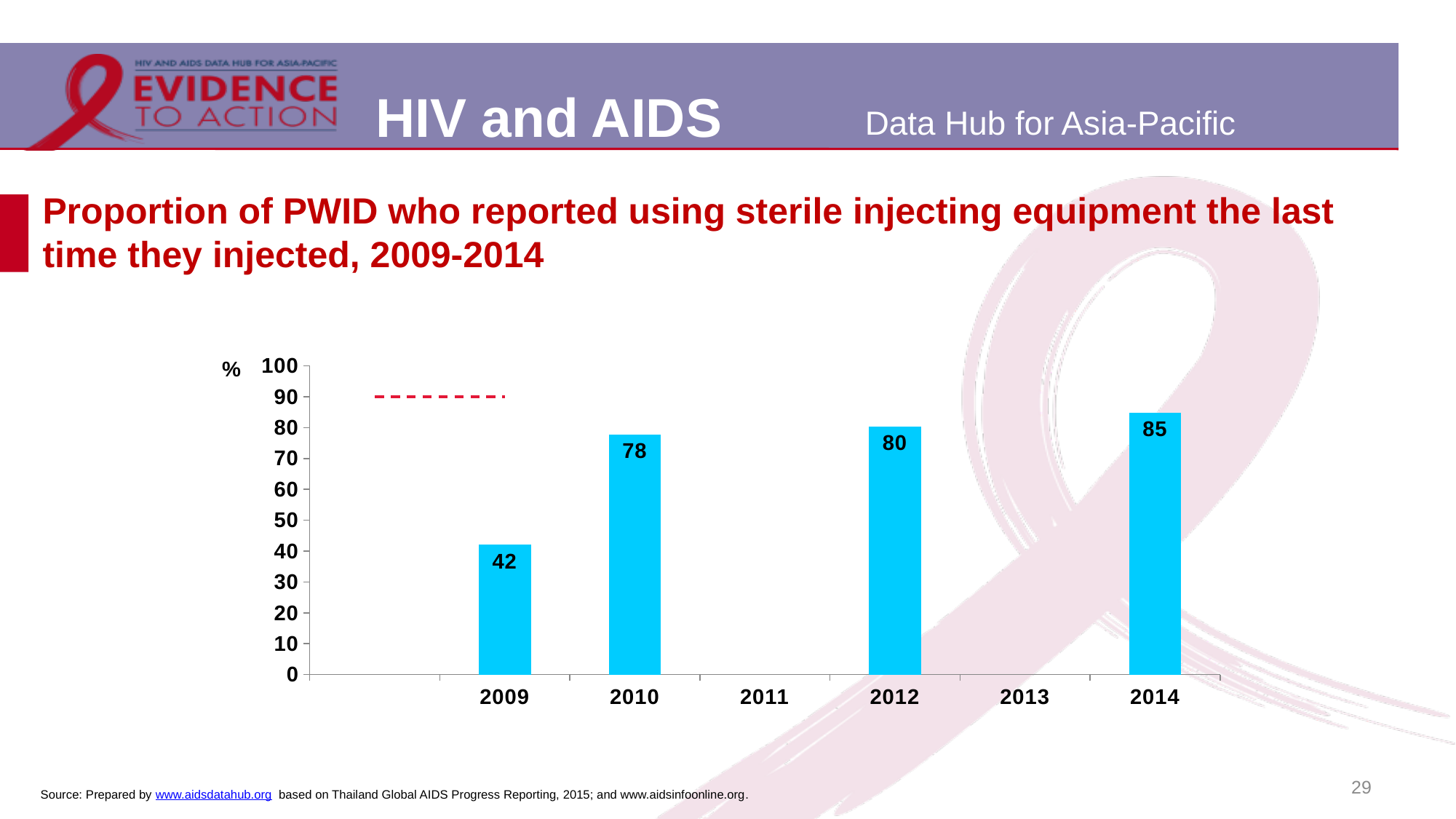
What is the value for 2010? 78 Which is larger, the value for 2010 or the value for 2012? 2012 Which year has the highest value? 2014 Do the plotted values rise or fall from 2009 to 2014? rise What is the value for 2014? 85 How many years on the x axis have a bar plotted? 4 What is the difference between the values for 2014 and 2009? 43 What kind of chart is shown on the slide? bar chart What is the value for 2009? 42 What is the value for 2012? 80 What is the label on the vertical axis? % Which year has the lowest value? 2009